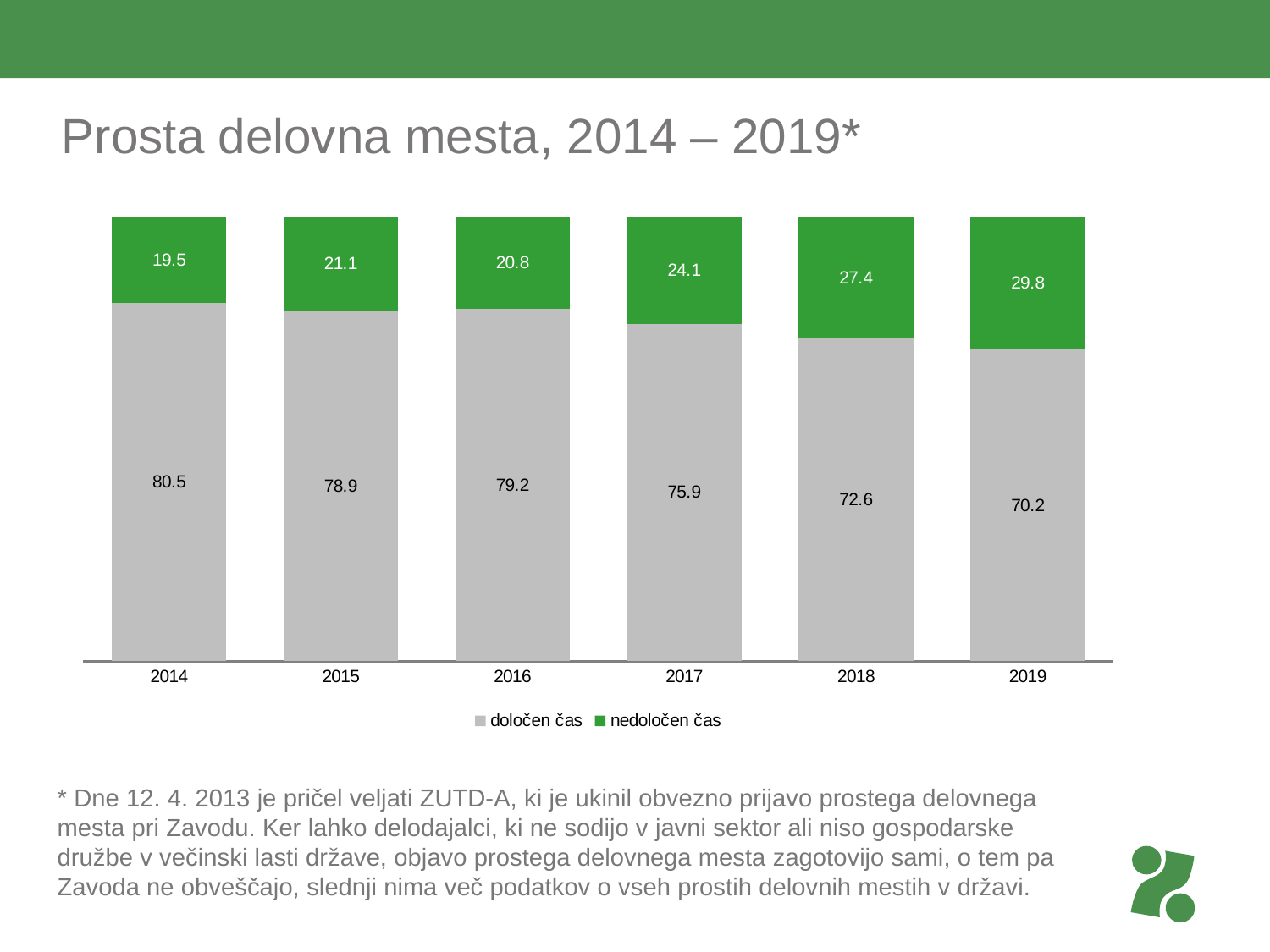
How many years are shown on the x axis? 6 What is the value for "določen čas" in 2014? 80.5 Which is larger: the "nedoločen čas" value for 2015 or for 2018? 2018 What is the value for "nedoločen čas" in 2019? 29.8 Which year has the lowest value for "določen čas"? 2019 What kind of chart is shown on the slide? Stacked bar chart What is the value for "nedoločen čas" in 2017? 24.1 What is the total of the stacked bar for 2018? 100 How many series does the legend list? 2 Does the "nedoločen čas" value rise or fall from 2016 to 2019? Rise Which year has the highest value for "nedoločen čas"? 2019 What is the difference between the "določen čas" values for 2014 and 2019? 10.3